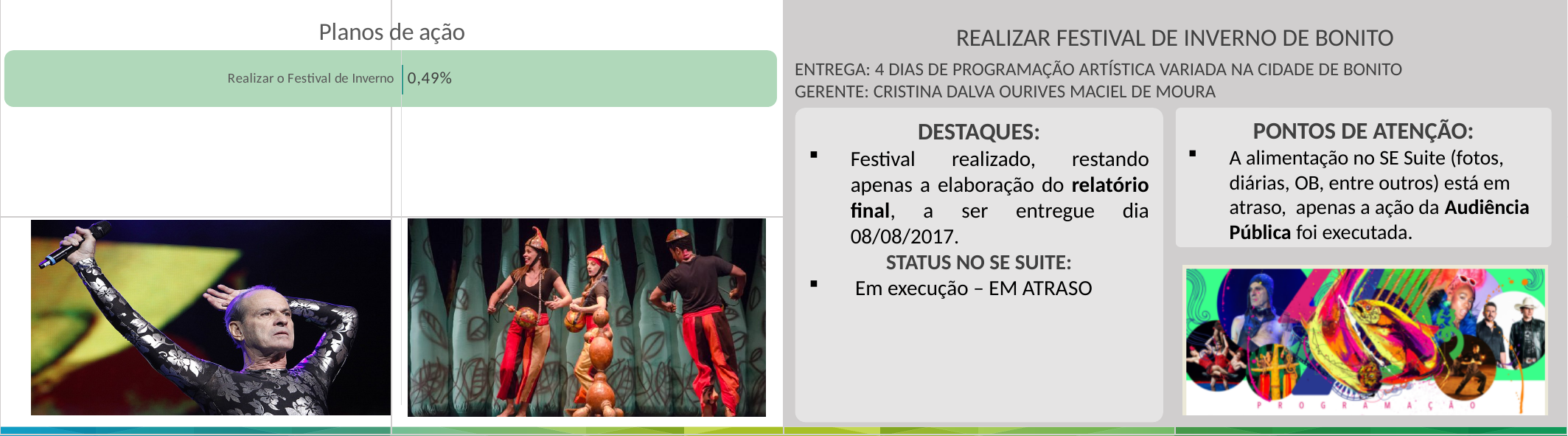
In the 'Planos de ação' chart, what value is shown for 'Realizar o Festival de Inverno'? 0,49% What is the title of the chart on the left side of the slide? Planos de ação In the 'Planos de ação' chart, is the value for 'Realizar o Festival de Inverno' greater or less than 1%? less How many categories does the 'Planos de ação' chart show? 1 What kind of chart is the 'Planos de ação' chart? bar chart What is the label of the only category in the 'Planos de ação' chart? Realizar o Festival de Inverno